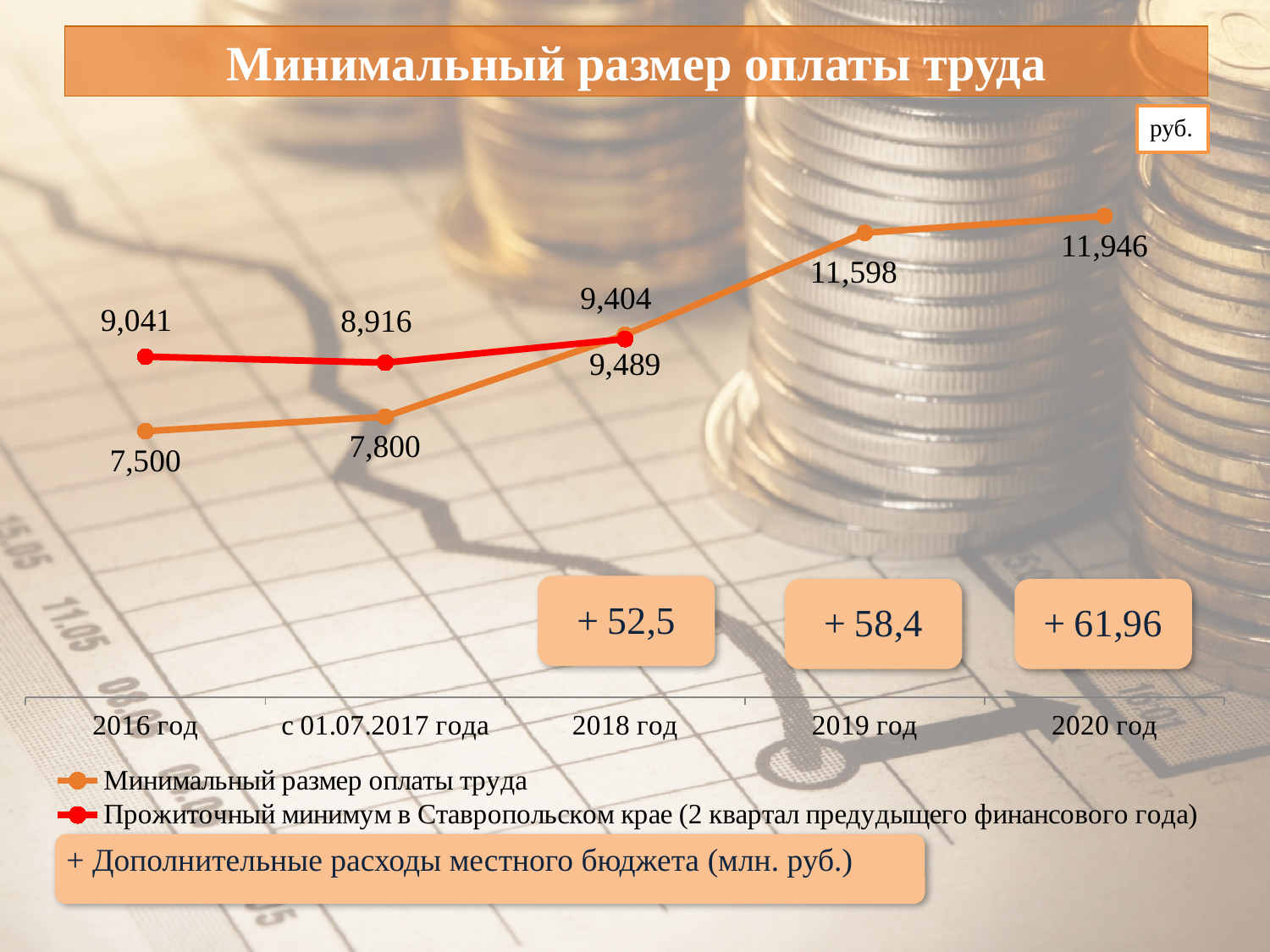
For 2016 год, which is larger: Минимальный размер оплаты труда or Прожиточный минимум в Ставропольском крае? Прожиточный минимум в Ставропольском крае In which period is Минимальный размер оплаты труда highest? 2020 год How many series does the legend list? 2 What is the value of Прожиточный минимум в Ставропольском крае for с 01.07.2017 года? 8,916 Does Минимальный размер оплаты труда rise or fall from 2016 год to 2020 год? Rise What is the value of Минимальный размер оплаты труда for 2016 год? 7,500 In which period is Минимальный размер оплаты труда lowest? 2016 год By how much did Минимальный размер оплаты труда increase from 2019 год to 2020 год? 348 How many periods are shown on the x axis of the chart? 5 What is the value of Прожиточный минимум в Ставропольском крае for 2016 год? 9,041 What is the value of Минимальный размер оплаты труда for 2020 год? 11,946 What type of chart is shown on the slide? Line chart